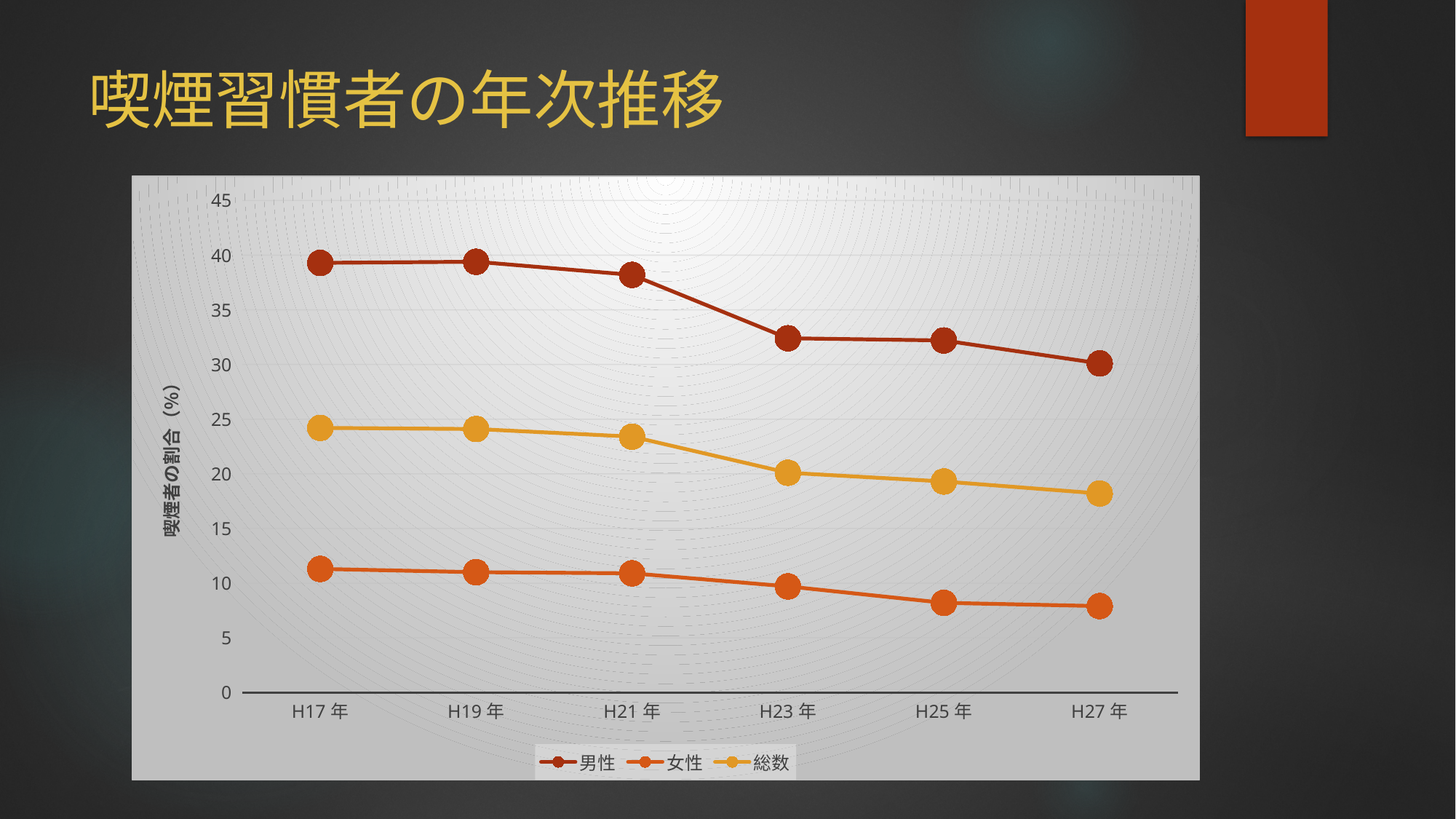
Is the value for 男性 in H27年 greater or less than 35? less Do the values for 総数 rise or fall from H17年 to H27年? fall What is the title of the slide? 喫煙習慣者の年次推移 Is the value for 男性 in H17年 greater or less than 35? greater Is the value for 女性 in H27年 greater or less than 10? less Which is larger for 男性: the value in H21年 or the value in H23年? H21年 What kind of chart is shown on the slide? line chart How many years are plotted along the x axis? 6 Which year has the lowest value for 男性? H27年 How many series does the legend list? 3